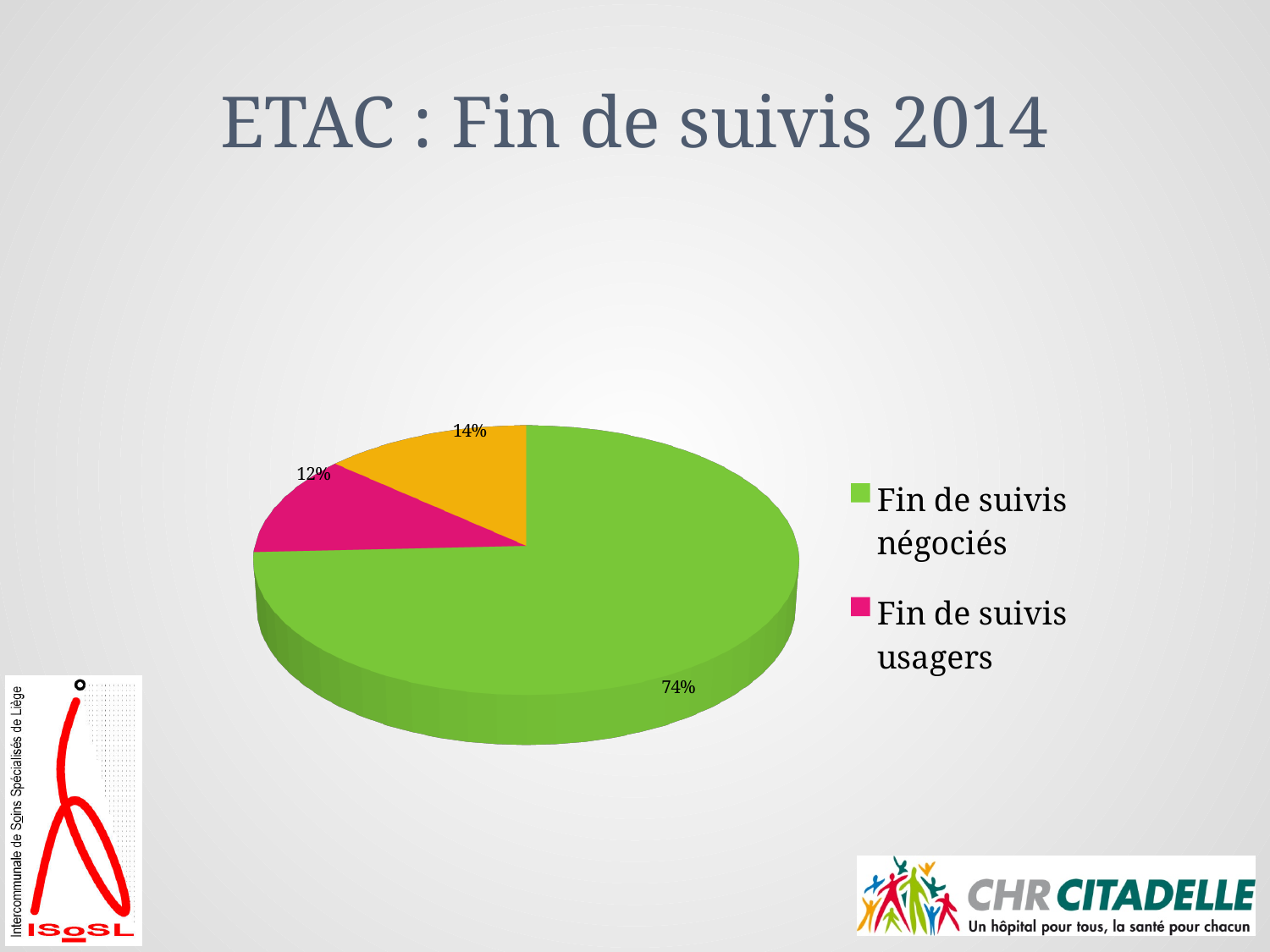
Which is larger, 'Fin de suivis négociés' or 'Fin de suivis usagers'? Fin de suivis négociés How many slices does the pie chart have? 3 Does 'Fin de suivis négociés' account for more or less than half of the pie? More What percentage of the pie is 'Fin de suivis usagers'? 12% Which slice of the pie is the smallest? Fin de suivis usagers What colour is the 'Fin de suivis usagers' slice? Pink What percentage of the pie is 'Fin de suivis négociés'? 74% What type of chart is shown on the slide? Pie chart How many entries does the legend list? 2 Which category has the largest slice of the pie? Fin de suivis négociés What is the title of the slide? ETAC : Fin de suivis 2014 What is the difference in percentage points between 'Fin de suivis négociés' and 'Fin de suivis usagers'? 62 percentage points